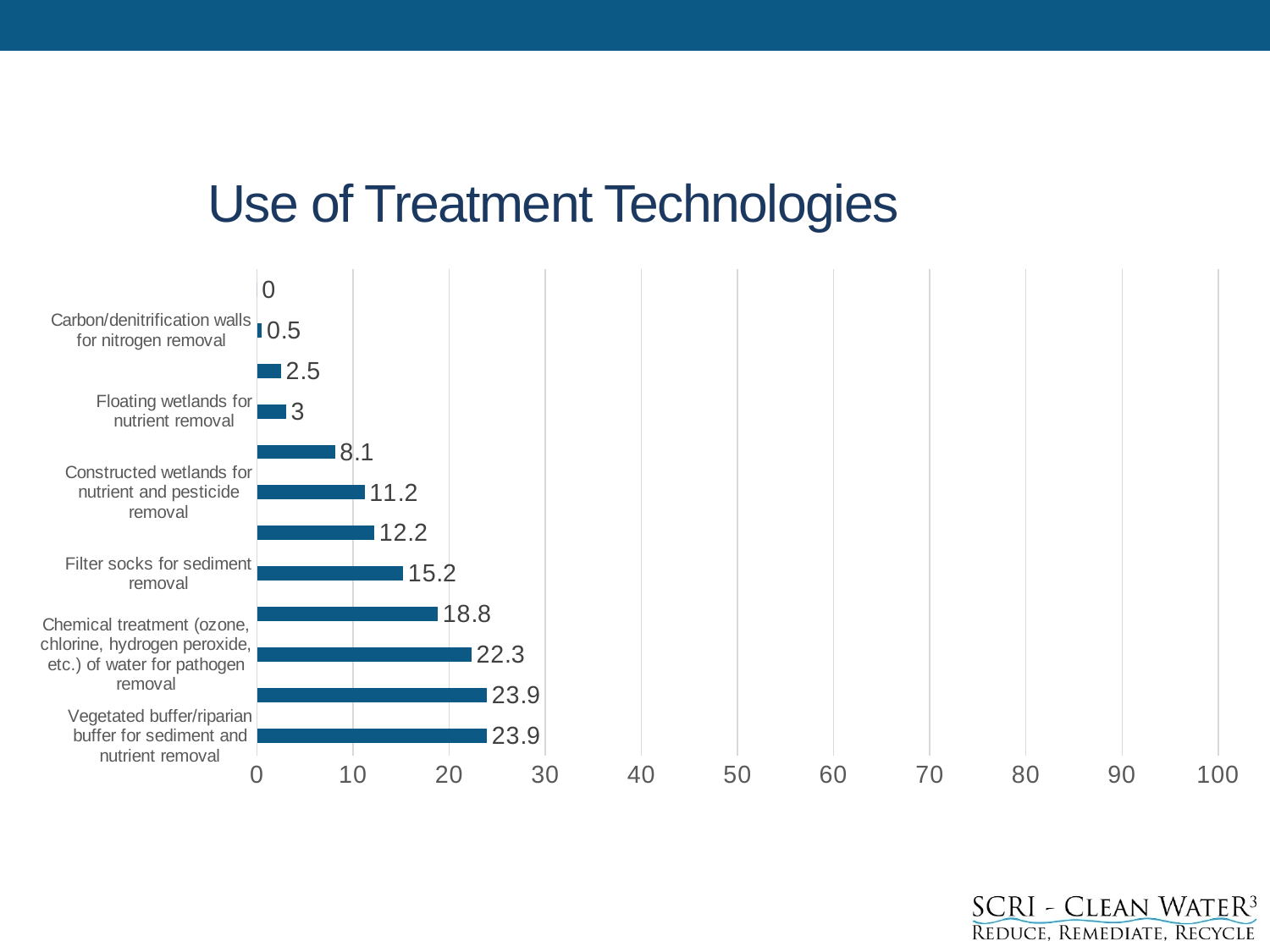
What is the value shown for Chemical treatment (ozone, chlorine, hydrogen peroxide, etc.) of water for pathogen removal? 22.3 What is the value shown for Constructed wetlands for nutrient and pesticide removal? 11.2 What type of chart is shown on the slide? bar chart What is the smallest value labelled on any bar in the chart? 0 What is the value shown for Vegetated buffer/riparian buffer for sediment and nutrient removal? 23.9 What is the value shown for Floating wetlands for nutrient removal? 3 What is the value shown for Filter socks for sediment removal? 15.2 How many bars are plotted in the chart? 12 What is the largest value labelled on any bar in the chart? 23.9 What is the difference between the value for Vegetated buffer/riparian buffer for sediment and nutrient removal and the value for Filter socks for sediment removal? 8.7 What is the value shown for Carbon/denitrification walls for nitrogen removal? 0.5 What is the title of the chart? Use of Treatment Technologies